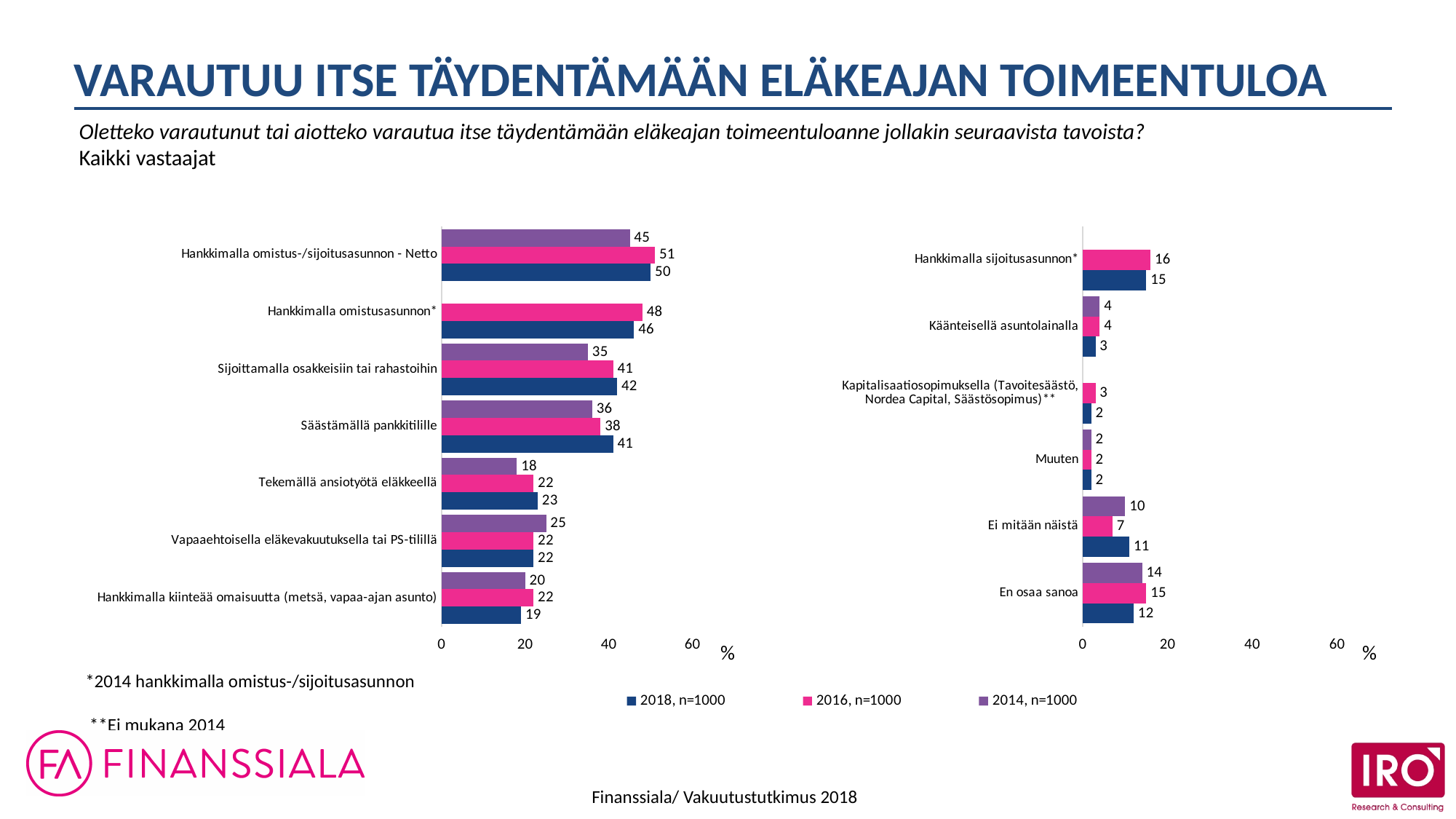
In the left chart, what is the 2014 value for 'Sijoittamalla osakkeisiin tai rahastoihin'? 35 In the left chart, is the 2018 value for 'Tekemällä ansiotyötä eläkkeellä' greater or less than 40? less How many categories are shown in the right chart? 6 In the left chart, what is the 2018 value for 'Säästämällä pankkitilille'? 41 How many series does the legend list? 3 In the right chart, what is the 2016 value for 'Ei mitään näistä'? 7 In the right chart, which is larger for 'En osaa sanoa': the 2016 value or the 2018 value? 2016 In the left chart, which category has the highest 2016 value? Hankkimalla omistus-/sijoitusasunnon - Netto What type of chart is the left chart? bar chart In the right chart, what is the 2018 value for 'Hankkimalla sijoitusasunnon*'? 15 In the left chart, what is the difference between the 2016 and 2014 values for 'Hankkimalla omistus-/sijoitusasunnon - Netto'? 6 In the right chart, which category has the lowest 2014 value? Muuten